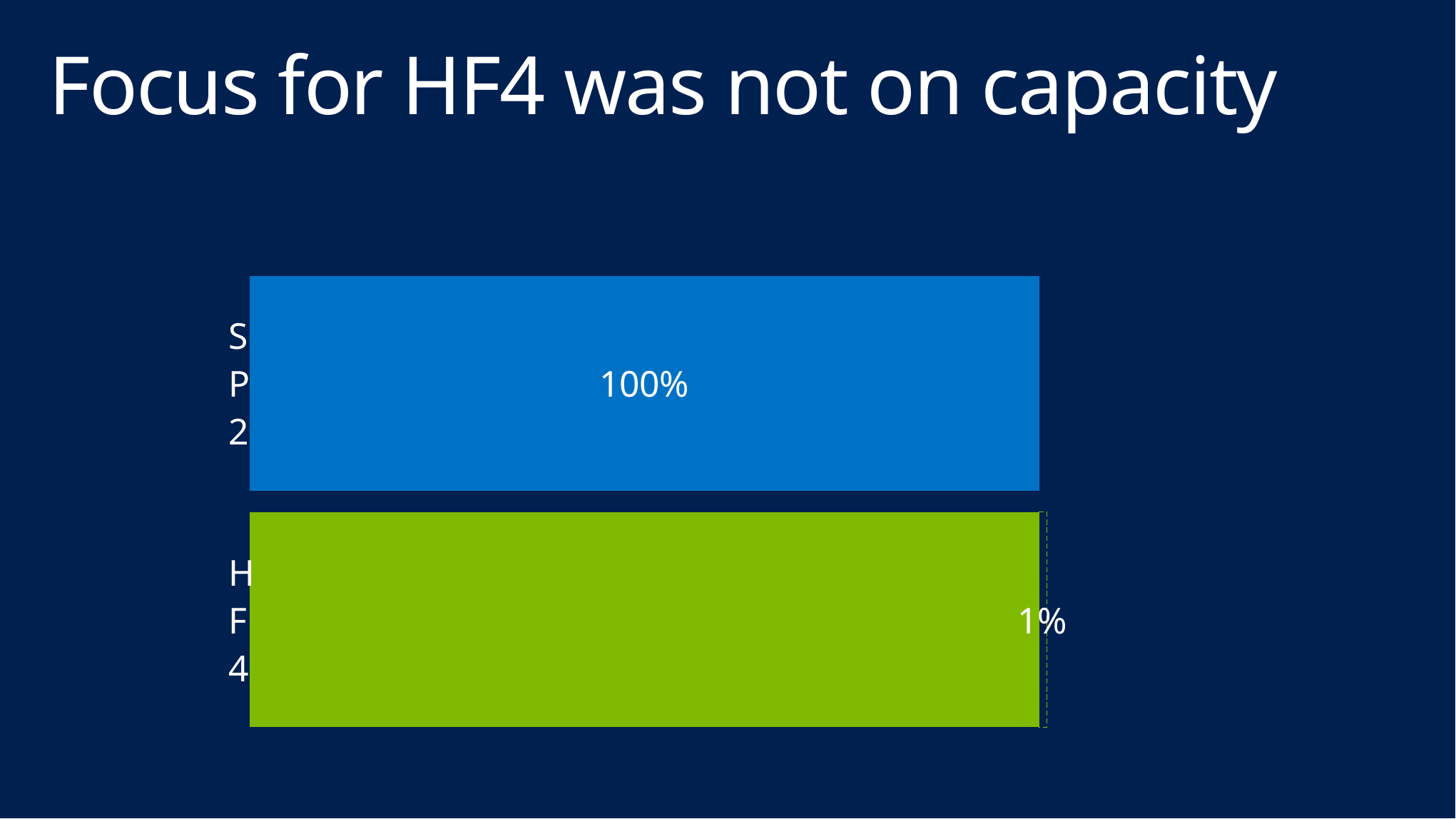
How many categories does the chart show? 2 What value is printed on the SP2 bar? 100% What colour is the SP2 bar? blue What kind of chart is shown on the slide? bar chart What is the title of the slide containing the chart? Focus for HF4 was not on capacity What value label is printed at the right end of the HF4 bar? 1% Which category is listed first (at the top) of the chart? SP2